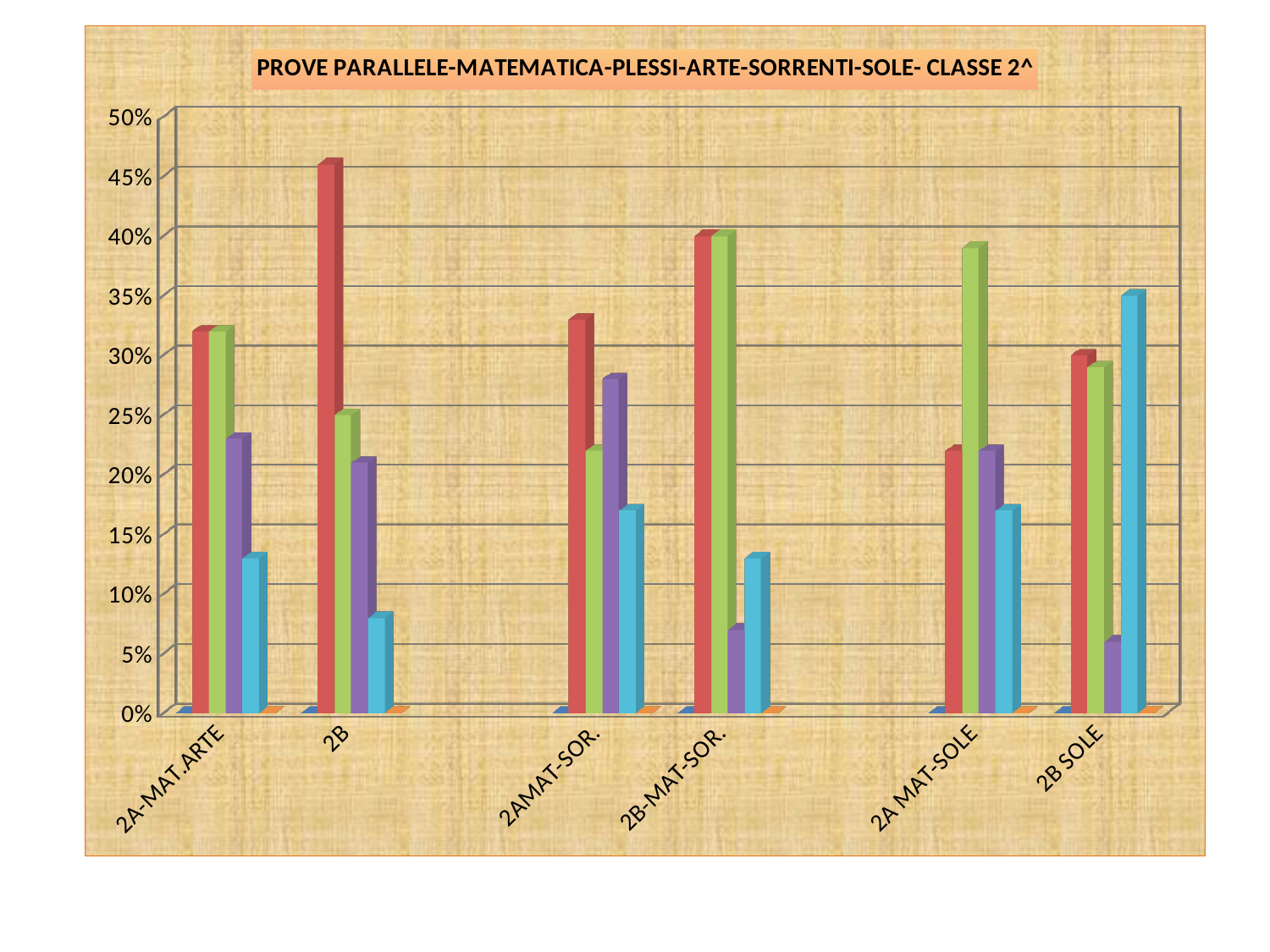
For the category 2B, which is larger: the red bar or the light blue bar? The red bar Is the value of the purple bar for 2B SOLE greater or less than 10%? less Which category has the tallest light blue bar? 2B SOLE What kind of chart is shown on the slide? Bar chart Is the value of the light blue bar for 2B greater or less than 10%? less What is the title of the chart? PROVE PARALLELE-MATEMATICA-PLESSI-ARTE-SORRENTI-SOLE- CLASSE 2^ For the category 2B-MAT-SOR., which is larger: the green bar or the purple bar? The green bar How many categories are shown on the x axis of the chart? 6 Which category has the tallest red bar? 2B Is the value of the light blue bar for 2B SOLE greater or less than 30%? greater